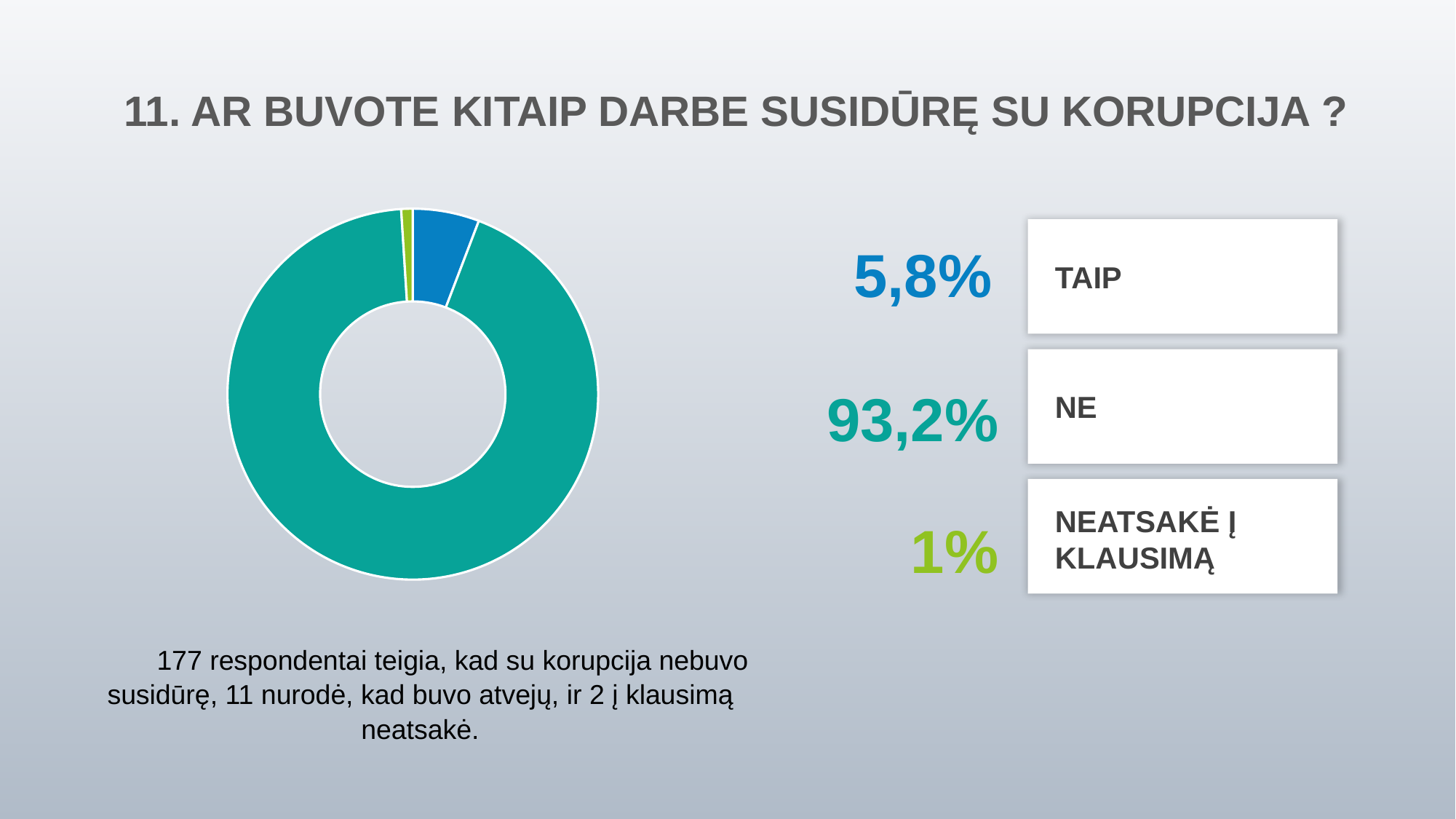
Which category has the smallest share of the chart? NEATSAKĖ Į KLAUSIMĄ Which category has the largest share of the chart? NE What kind of chart is shown on the slide? Donut (pie) chart What share of respondents answered "TAIP"? 5,8% What share of respondents did not answer the question ("NEATSAKĖ Į KLAUSIMĄ")? 1% According to the text below the chart, how many respondents did not answer the question? 2 What colour is the slice representing "NE"? Teal (green-blue) What share of respondents answered "NE"? 93,2% What is the difference in percentage points between "NE" and "TAIP"? 87,4 Which is larger, the share for "TAIP" or the share for "NEATSAKĖ Į KLAUSIMĄ"? TAIP According to the text below the chart, how many respondents said they had not encountered corruption? 177 How many categories does the chart show? 3